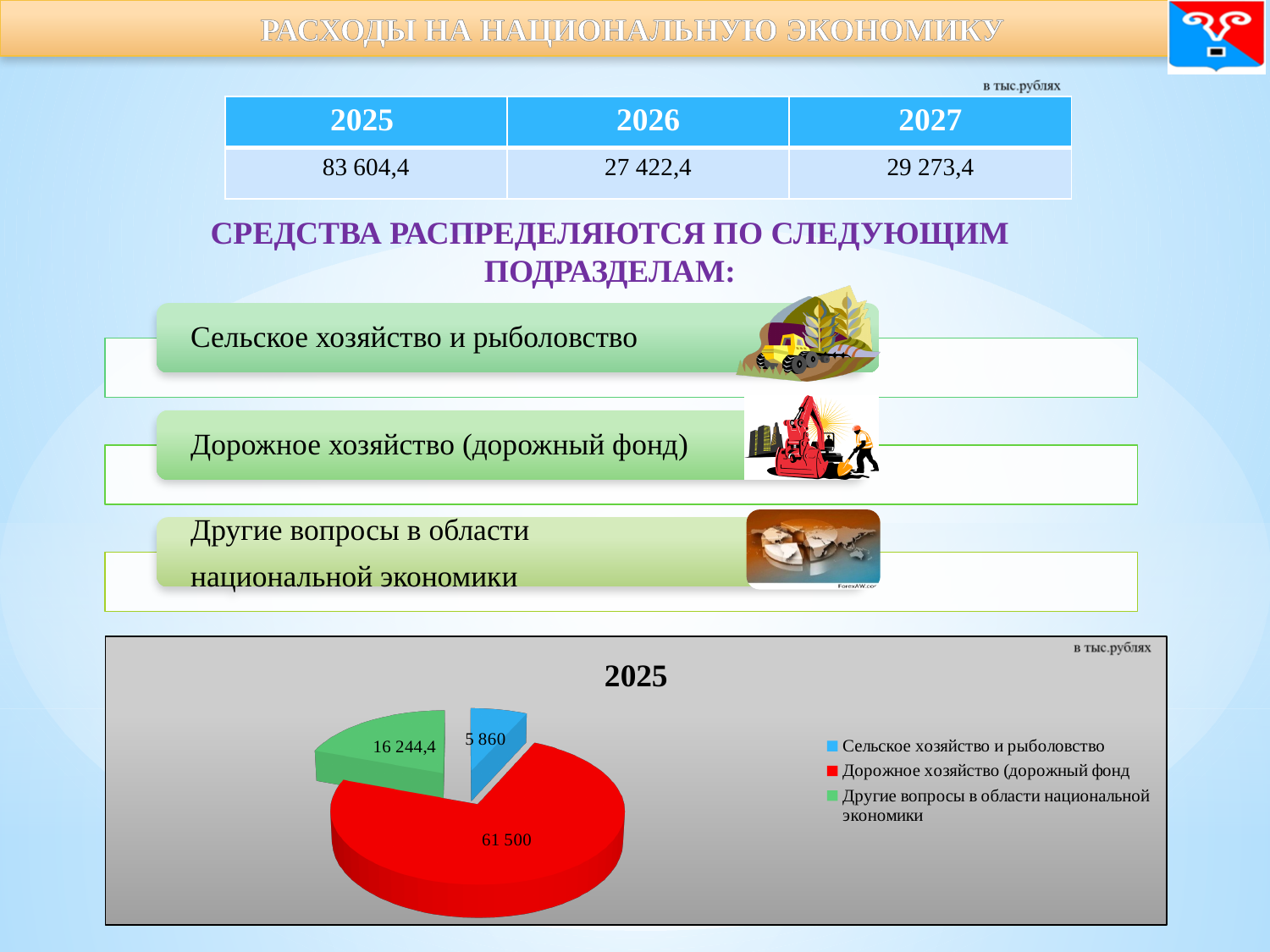
In the pie chart, what is the difference between the values for Дорожное хозяйство (дорожный фонд) and Сельское хозяйство и рыболовство? 55 640 Which category has the smallest slice in the pie chart? Сельское хозяйство и рыболовство What is the value for Сельское хозяйство и рыболовство in the pie chart? 5 860 What type of chart is shown at the bottom of the slide? pie chart What is the value for Дорожное хозяйство (дорожный фонд) in the pie chart? 61 500 What colour is the slice for Дорожное хозяйство (дорожный фонд) in the pie chart? red What is the title of the pie chart? 2025 In the pie chart, which is larger: Другие вопросы в области национальной экономики or Сельское хозяйство и рыболовство? Другие вопросы в области национальной экономики How many slices does the pie chart have? 3 Which category has the largest slice in the pie chart? Дорожное хозяйство (дорожный фонд) What is the value for Другие вопросы в области национальной экономики in the pie chart? 16 244,4 How many entries does the legend of the pie chart list? 3